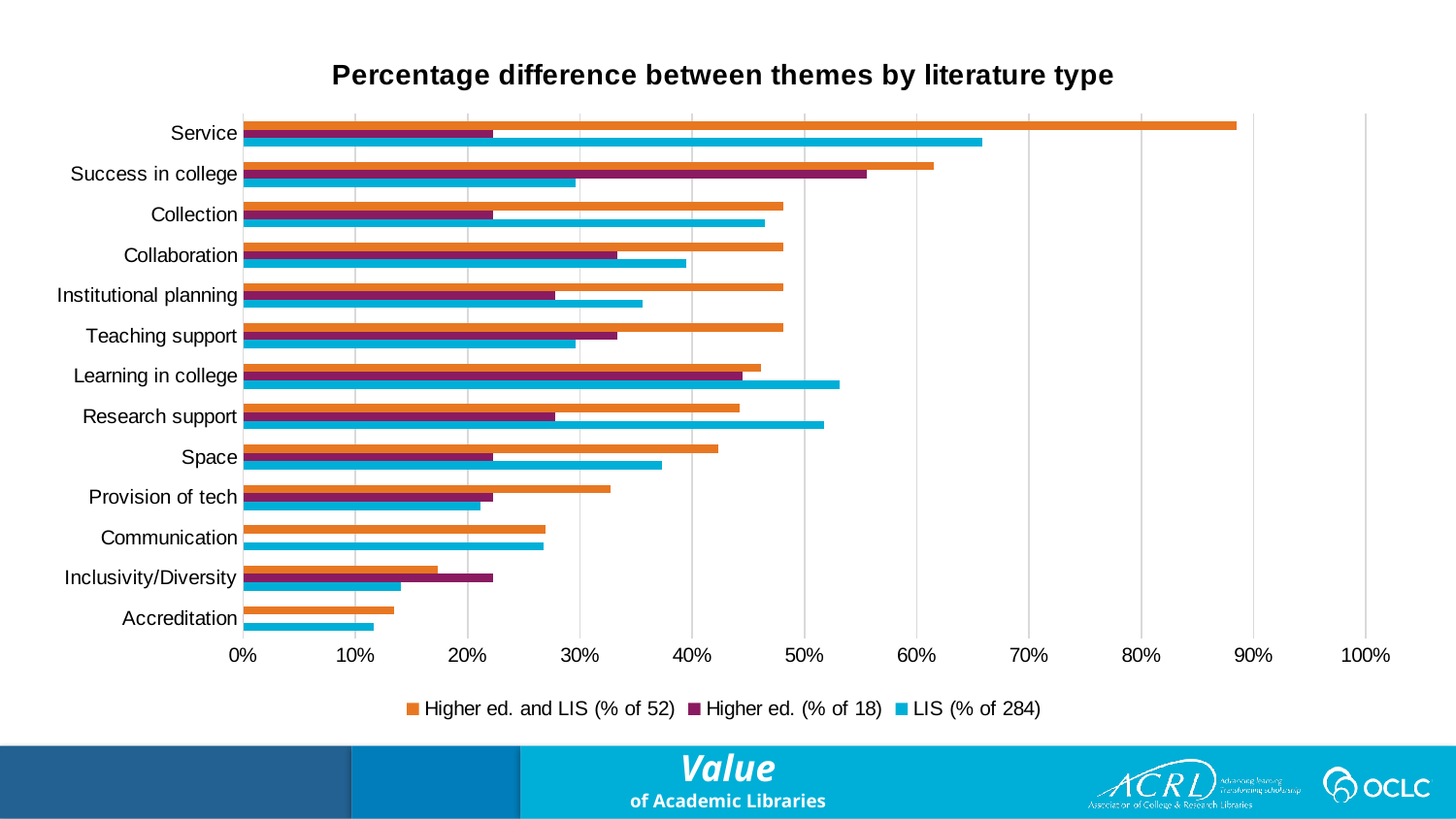
Is the Higher ed. (% of 18) value for Success in college greater or less than 50%? greater Which theme has the highest value for the Higher ed. and LIS (% of 52) series? Service What is the title of the chart? Percentage difference between themes by literature type For Learning in college, which is larger: the LIS (% of 284) value or the Higher ed. and LIS (% of 52) value? LIS (% of 284) Is the LIS (% of 284) value for Service greater or less than 60%? greater What type of chart is shown on the slide? Bar chart How many themes (categories) are plotted on the chart? 13 For Research support, which is larger: the LIS (% of 284) value or the Higher ed. and LIS (% of 52) value? LIS (% of 284) Which theme has the highest value for the Higher ed. (% of 18) series? Success in college Is the Higher ed. and LIS (% of 52) value for Service greater or less than 80%? greater How many series does the legend list? 3 Which theme has the lowest value for the Higher ed. and LIS (% of 52) series? Accreditation